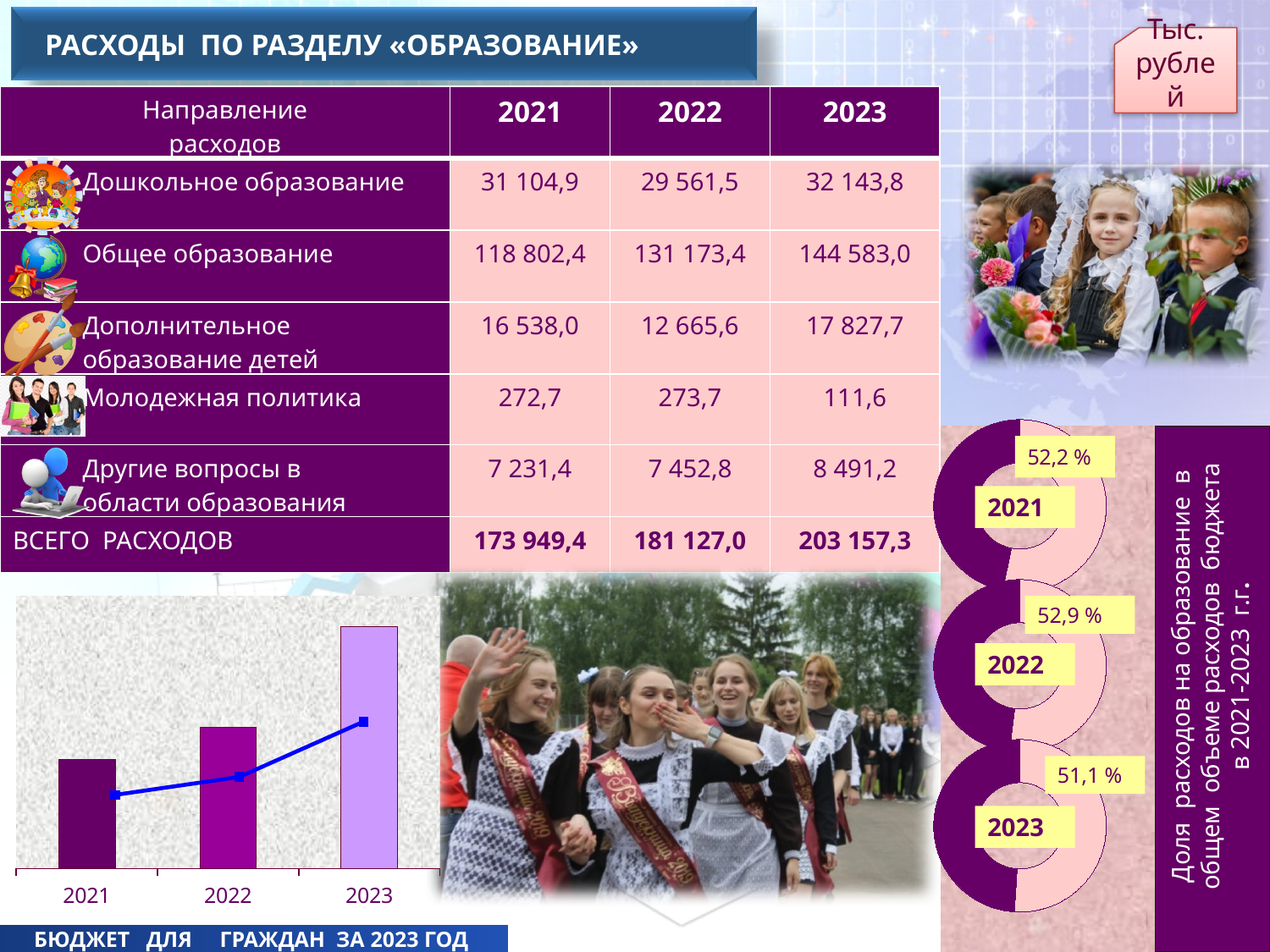
How many bars are plotted in the bar chart at the bottom left of the slide? 3 In the bar chart at the bottom left, is the bar for 2022 taller or shorter than the bar for 2021? taller In the donut charts on the right of the slide, which year has the lowest share of education expenditure? 2023 In the bar chart at the bottom left, do the bars rise or fall from 2021 to 2023? rise In the bar chart at the bottom left, what are the category labels on the x axis? 2021, 2022, 2023 In the donut charts on the right of the slide, what share of budget expenditure went to education in 2023? 51,1 % In the donut charts on the right of the slide, what share of budget expenditure went to education in 2022? 52,9 % What kind of chart is shown at the bottom left of the slide? bar chart In the donut charts on the right of the slide, what share of budget expenditure went to education in 2021? 52,2 % In the donut charts on the right of the slide, which year has the highest share of education expenditure? 2022 In the bar chart at the bottom left, which year has the shortest bar? 2021 In the bar chart at the bottom left, which year has the tallest bar? 2023